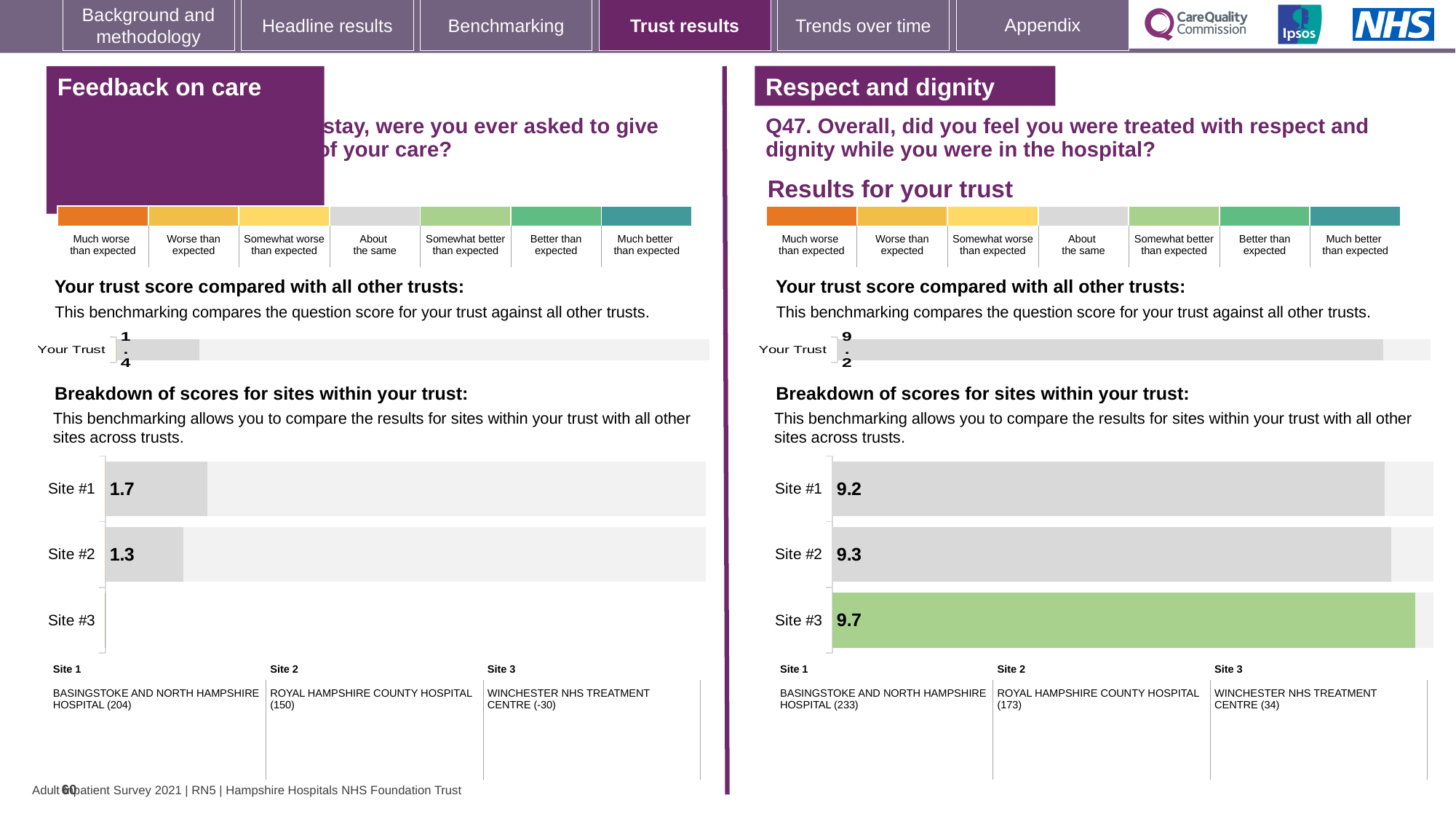
In the 'Respect and dignity' breakdown of scores for sites chart, which site has the lowest score? Site #1 In the 'Feedback on care' breakdown of scores for sites chart, what is the score for Site #1? 1.7 In the 'Respect and dignity' breakdown of scores for sites chart, what is the score for Site #3? 9.7 In the 'Feedback on care' breakdown of scores for sites chart, what is the difference between the scores for Site #1 and Site #2? 0.4 In the 'Respect and dignity' breakdown of scores for sites chart, what is the score for Site #1? 9.2 In the 'Feedback on care' section, what is the 'Your Trust' score shown in the trust comparison chart? 1.4 What type of chart is used for the 'Respect and dignity' breakdown of scores for sites? Bar chart In the 'Respect and dignity' section, what is the 'Your Trust' score shown in the trust comparison chart? 9.2 In the 'Respect and dignity' breakdown of scores for sites chart, which site has the highest score? Site #3 In the 'Feedback on care' breakdown of scores for sites chart, what is the score for Site #2? 1.3 In the 'Feedback on care' breakdown of scores for sites chart, which has the larger score, Site #1 or Site #2? Site #1 In the 'Respect and dignity' breakdown of scores for sites chart, what is the difference between the scores for Site #3 and Site #1? 0.5